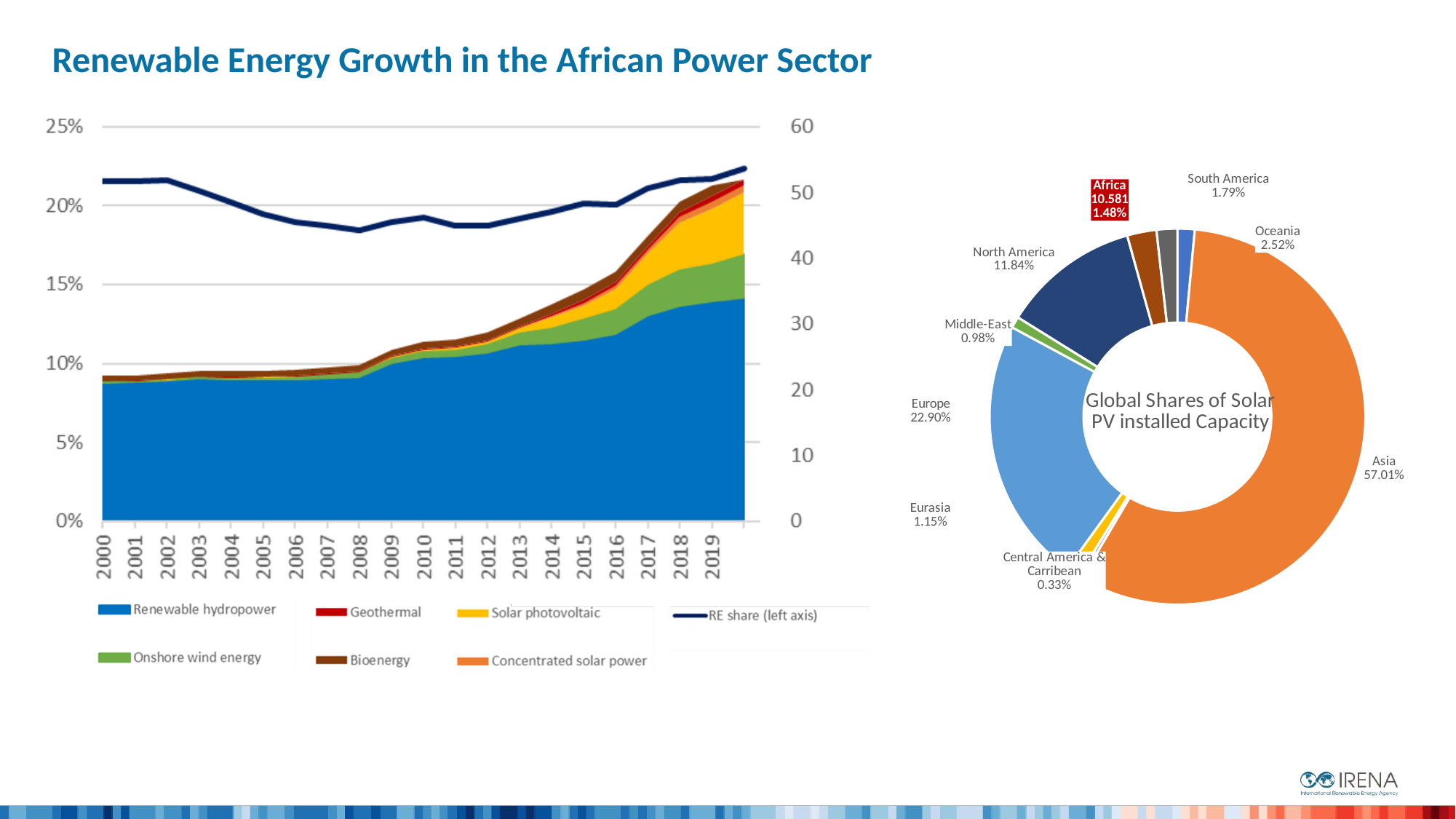
In the Global Shares of Solar PV installed Capacity chart, which has a larger share, Oceania or South America? Oceania In the left-hand chart, which series is shown in dark blue as a line? RE share (left axis) In the Global Shares of Solar PV installed Capacity chart, what is the difference between the shares of Europe and North America? 11.06% In the Global Shares of Solar PV installed Capacity chart, what share does Europe hold? 22.90% In the left-hand chart, is the RE share in 2008 greater or less than 20%? less How many series does the legend of the left-hand chart list? 7 In the Global Shares of Solar PV installed Capacity chart, what share does Asia hold? 57.01% In the Global Shares of Solar PV installed Capacity chart, which region has the smallest share? Central America & Carribean What kind of chart is the Global Shares of Solar PV installed Capacity chart? Doughnut chart In the Global Shares of Solar PV installed Capacity chart, which region has the largest share? Asia How many regions are shown in the Global Shares of Solar PV installed Capacity chart? 9 In the Global Shares of Solar PV installed Capacity chart, what share does Africa hold? 1.48%